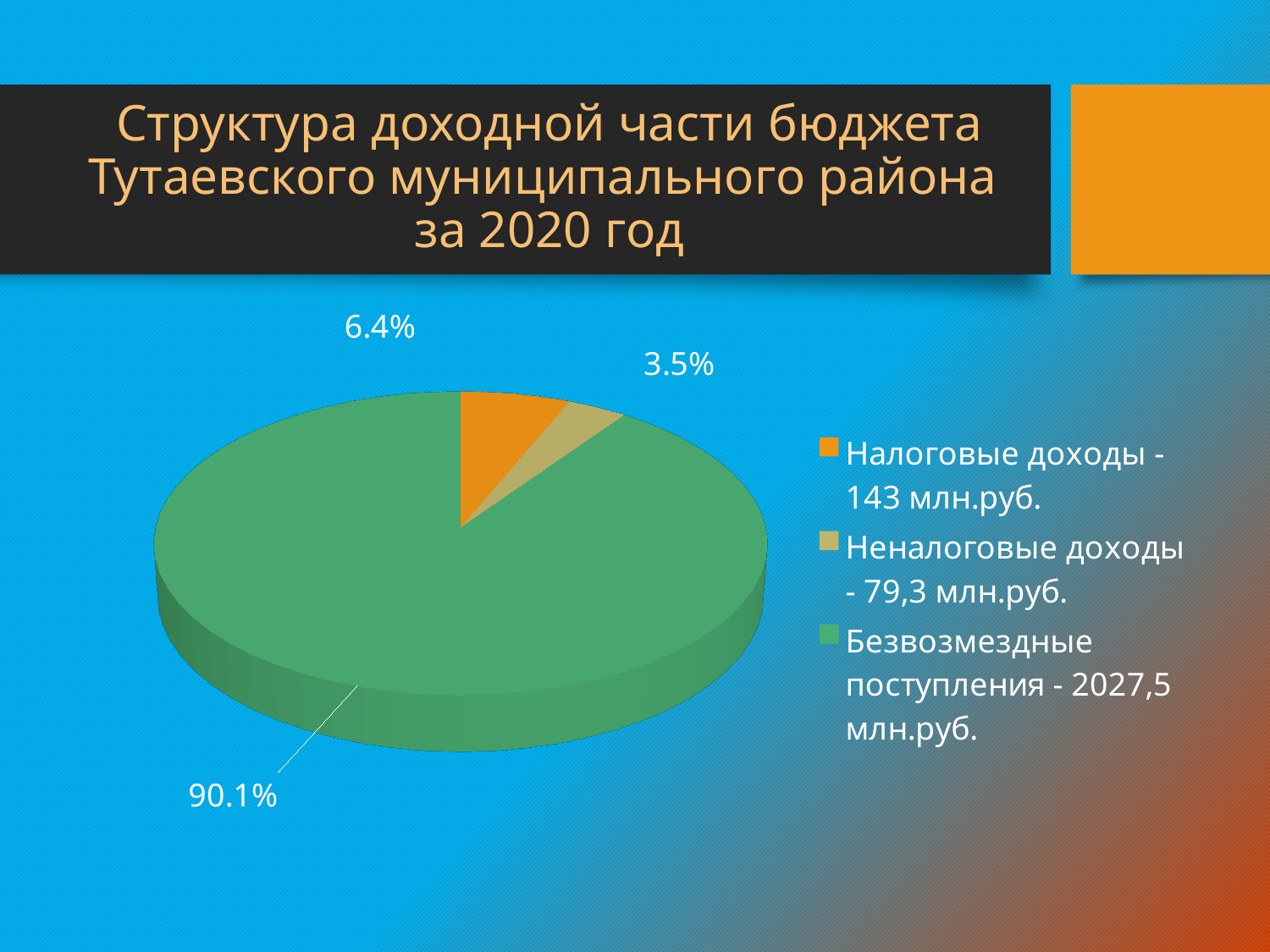
What kind of chart is shown on the slide? pie chart What share of the pie is labelled for Безвозмездные поступления? 90.1% By how many percentage points does the share of Безвозмездные поступления exceed that of Налоговые доходы? 83.7 How many slices does the pie chart have? 3 What share of the pie is labelled for Налоговые доходы? 6.4% According to the legend, what amount in млн.руб. corresponds to Налоговые доходы? 143 млн.руб. What share of the pie is labelled for Неналоговые доходы? 3.5% Which slice is larger: Налоговые доходы or Неналоговые доходы? Налоговые доходы What colour is the slice for Безвозмездные поступления? green Which category has the smallest slice of the pie? Неналоговые доходы By how many percentage points does the share of Налоговые доходы exceed that of Неналоговые доходы? 2.9 Which category has the largest slice of the pie? Безвозмездные поступления